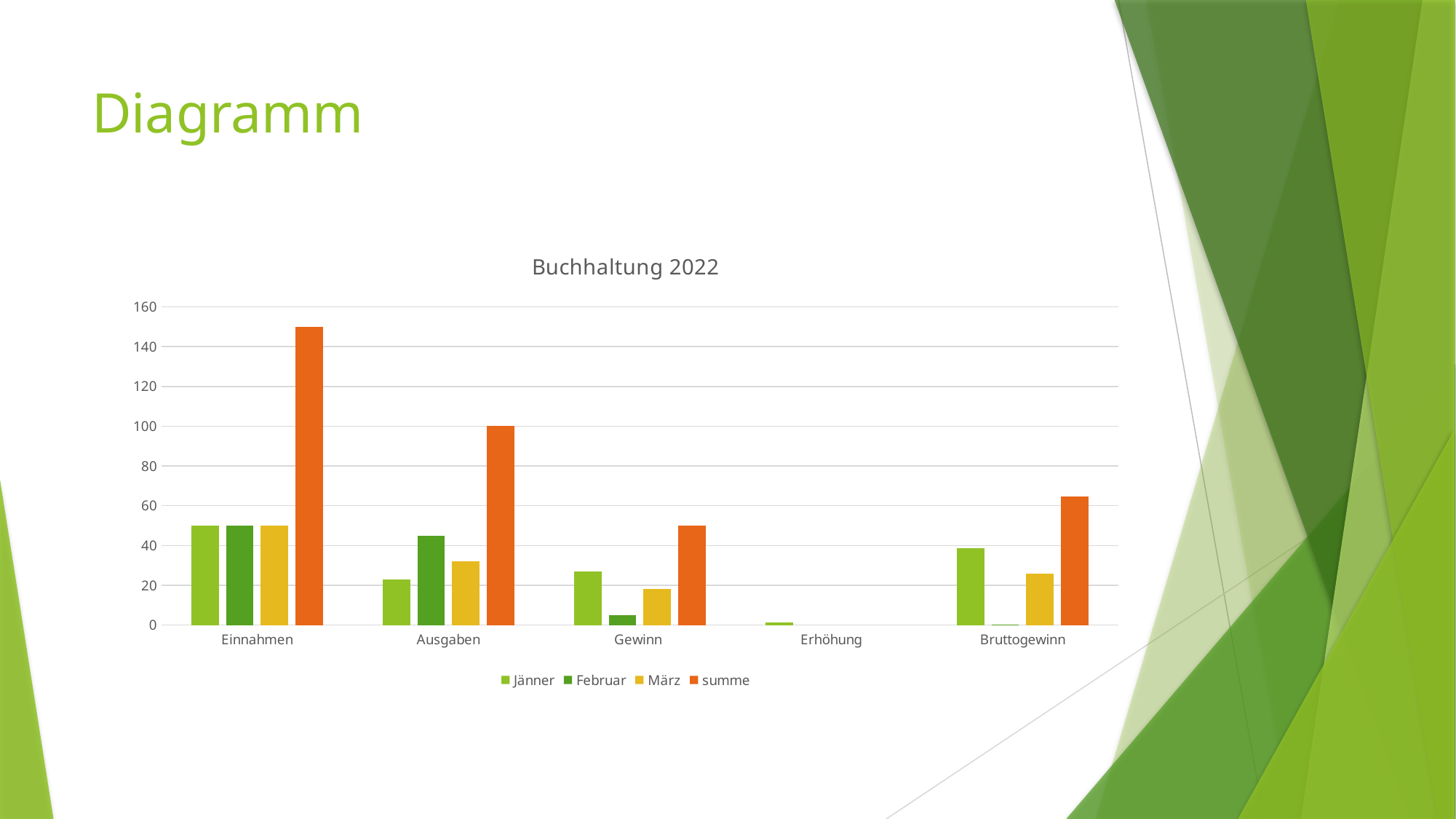
What is the summe value for Ausgaben? 100 Is the summe value for Bruttogewinn greater or less than 60? greater How many series does the legend list? 4 Is the summe value for Einnahmen greater or less than 140? greater Which is larger, the Jänner value for Gewinn or the Februar value for Gewinn? Jänner What kind of chart is shown on the slide? bar chart How many categories are shown on the x axis? 5 What is the title of the chart? Buchhaltung 2022 Is the Februar value for Ausgaben greater or less than 40? greater Which category has the lowest Jänner value? Erhöhung Which series is shown in orange in the legend? summe Which category has the highest summe value? Einnahmen